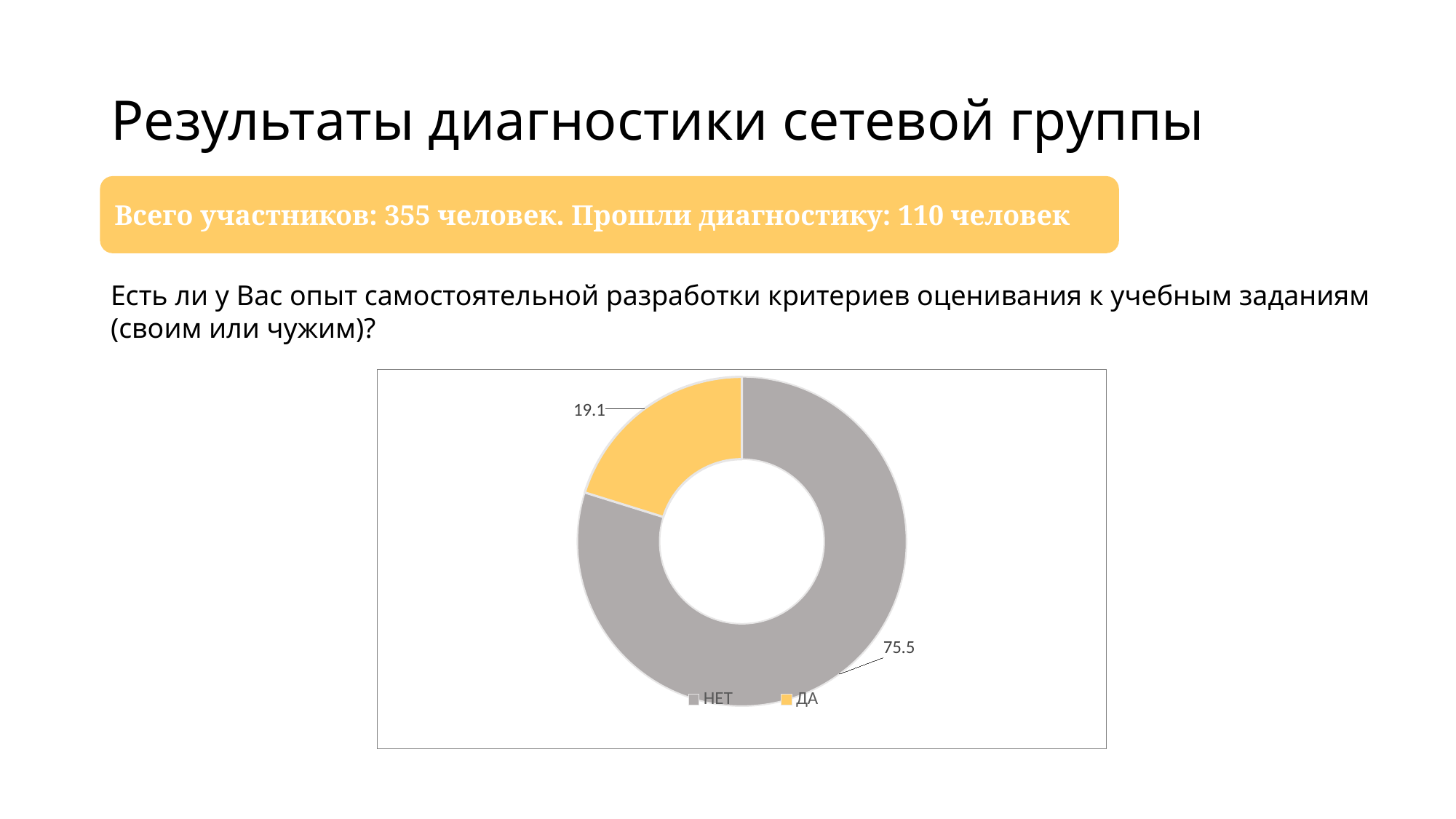
How many categories are shown in the chart? 2 What value is shown for the НЕТ slice in the doughnut chart? 75.5 What is the difference between the НЕТ value and the ДА value? 56.4 What type of chart is shown on the slide? Doughnut (pie) chart What are the two legend entries of the chart? НЕТ and ДА Which category has the largest slice in the chart? НЕТ Which slice is larger, НЕТ or ДА? НЕТ What colour is the ДА slice in the chart? Yellow Which category has the smallest slice in the chart? ДА What value is shown for the ДА slice in the doughnut chart? 19.1 How many entries does the chart legend list? 2